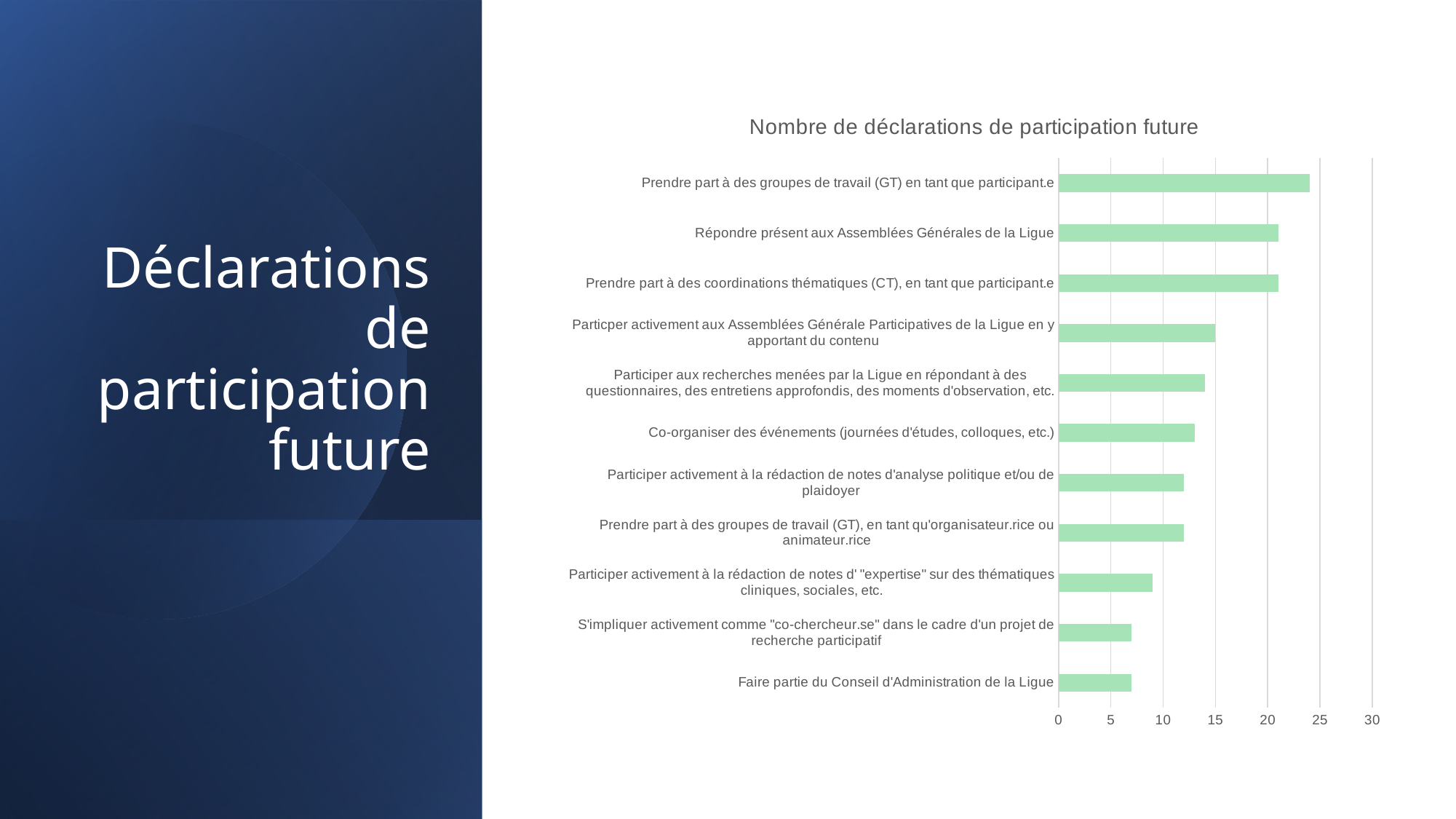
Is the value for "Prendre part à des groupes de travail (GT) en tant que participant.e" greater or less than 20? greater Is the value for "Répondre présent aux Assemblées Générales de la Ligue" greater or less than 20? greater Is the value for "Participer activement à la rédaction de notes d' "expertise" sur des thématiques cliniques, sociales, etc." greater or less than 10? less What is the title of the chart? Nombre de déclarations de participation future Which is larger: the value for "Co-organiser des événements (journées d'études, colloques, etc.)" or the value for "S'impliquer activement comme "co-chercheur.se" dans le cadre d'un projet de recherche participatif"? Co-organiser des événements (journées d'études, colloques, etc.) Which is larger: the value for "Faire partie du Conseil d'Administration de la Ligue" or the value for "Répondre présent aux Assemblées Générales de la Ligue"? Répondre présent aux Assemblées Générales de la Ligue What kind of chart is shown on the slide? Bar chart Which category has the highest number of declarations? Prendre part à des groupes de travail (GT) en tant que participant.e How many categories are plotted in the chart? 11